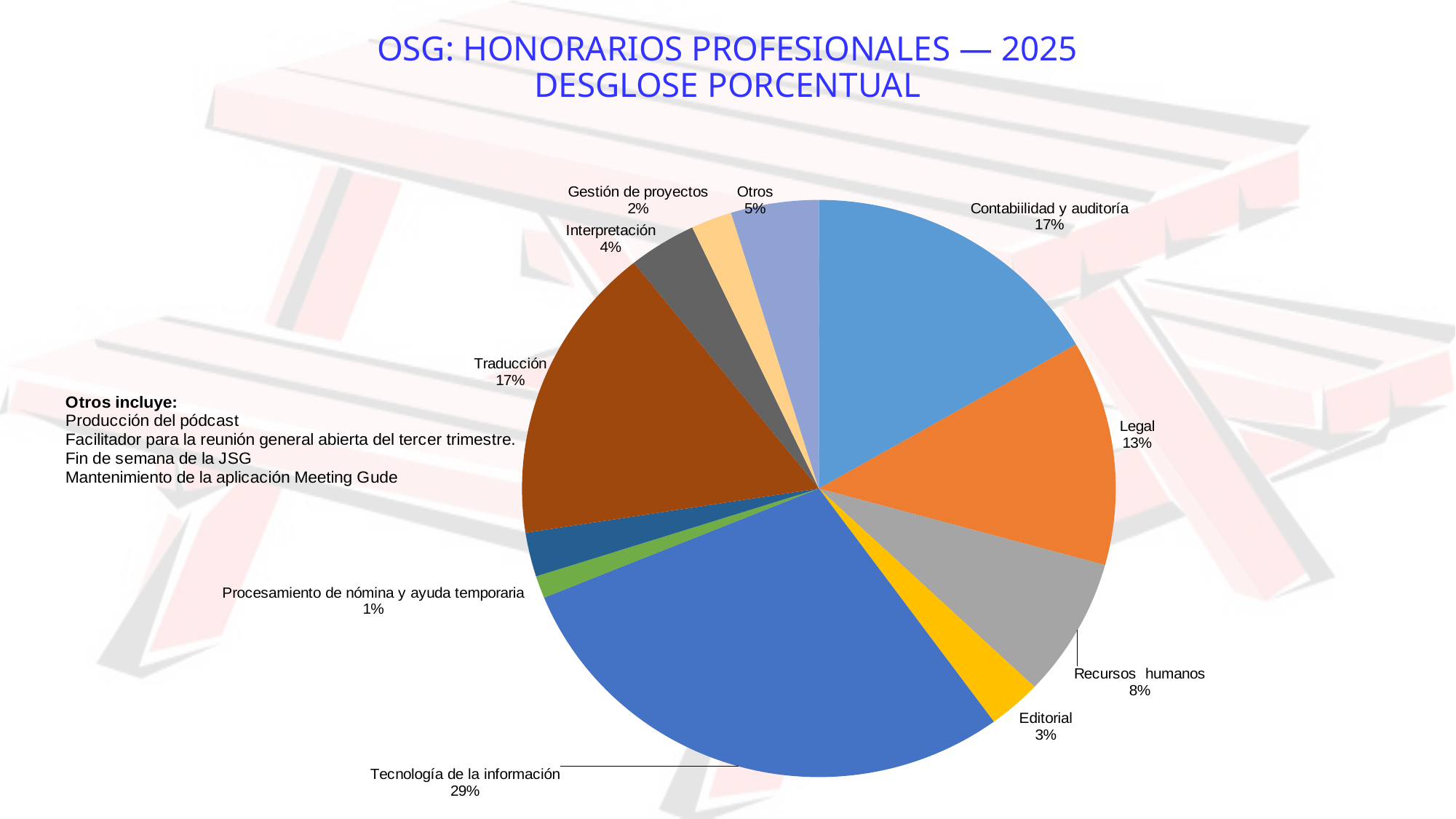
What type of chart is shown on the slide? Pie chart What is the difference in percentage points between Contabilidad y auditoría and Legal? 4 percentage points What is the value shown for Legal? 13% What is the value shown for Recursos humanos? 8% Which labelled category has the smallest share of the pie? Procesamiento de nómina y ayuda temporaria What is the title of the chart? OSG: HONORARIOS PROFESIONALES — 2025 DESGLOSE PORCENTUAL Which category has the largest share of the pie? Tecnología de la información What share of the pie does Otros represent? 5% Which is larger, Interpretación or Editorial? Interpretación What percentage of the pie does Tecnología de la información represent? 29% What is the difference in percentage points between Tecnología de la información and Traducción? 12 percentage points What is the value shown for Gestión de proyectos? 2%